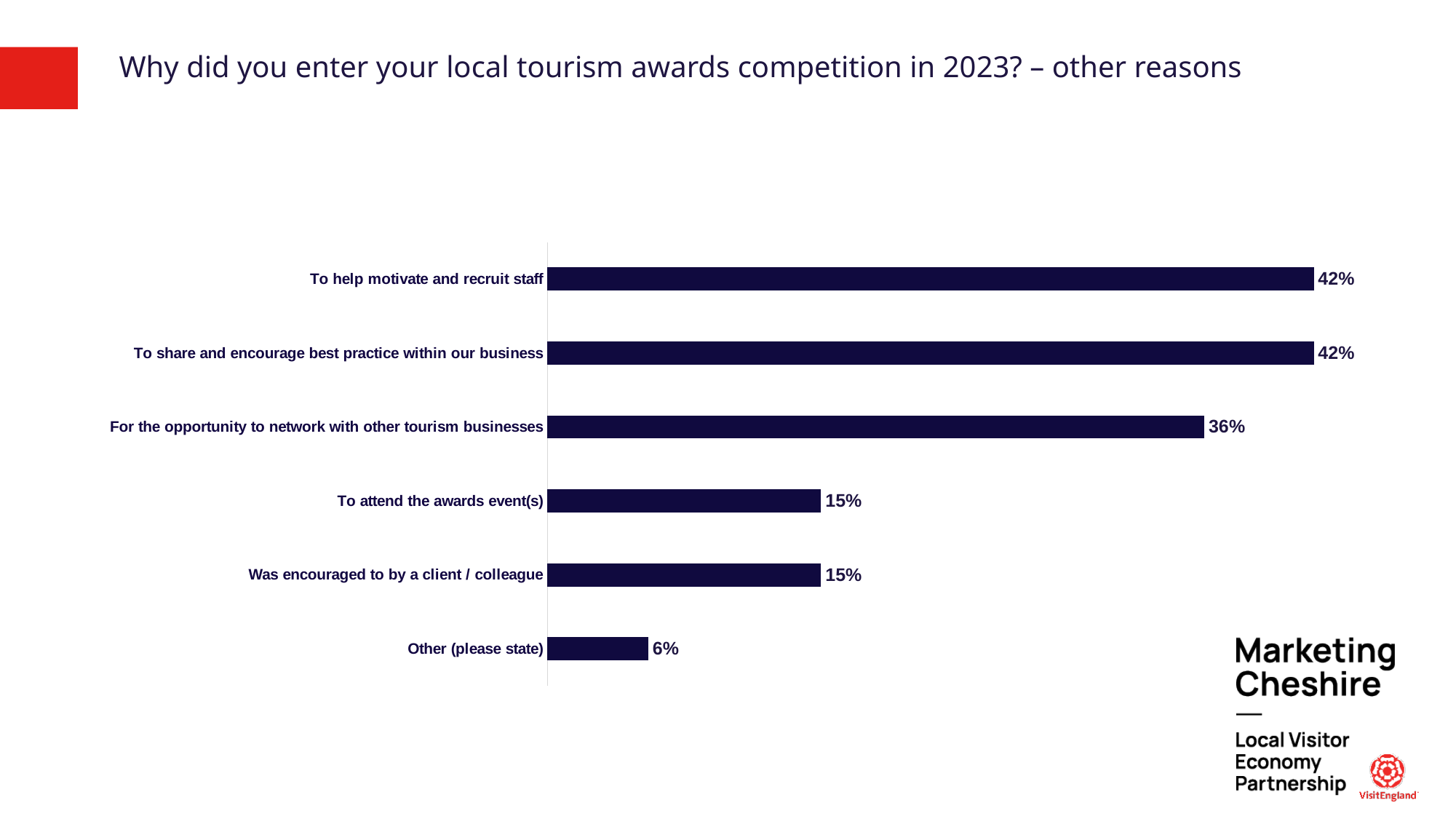
What type of chart is shown on the slide? Bar chart What is the value for 'Other (please state)'? 6% What percentage selected 'To attend the awards event(s)'? 15% How many reasons are shown in the chart? 6 Which reason has the lowest percentage? Other (please state) Which is larger: 'For the opportunity to network with other tourism businesses' or 'Was encouraged to by a client / colleague'? For the opportunity to network with other tourism businesses What percentage were encouraged to enter by a client / colleague? 15% What is the value for 'For the opportunity to network with other tourism businesses'? 36% What is the title of the slide? Why did you enter your local tourism awards competition in 2023? – other reasons What is the difference between 'To attend the awards event(s)' and 'Other (please state)'? 9% What is the difference between 'To help motivate and recruit staff' and 'For the opportunity to network with other tourism businesses'? 6% What percentage of respondents entered the awards to help motivate and recruit staff? 42%